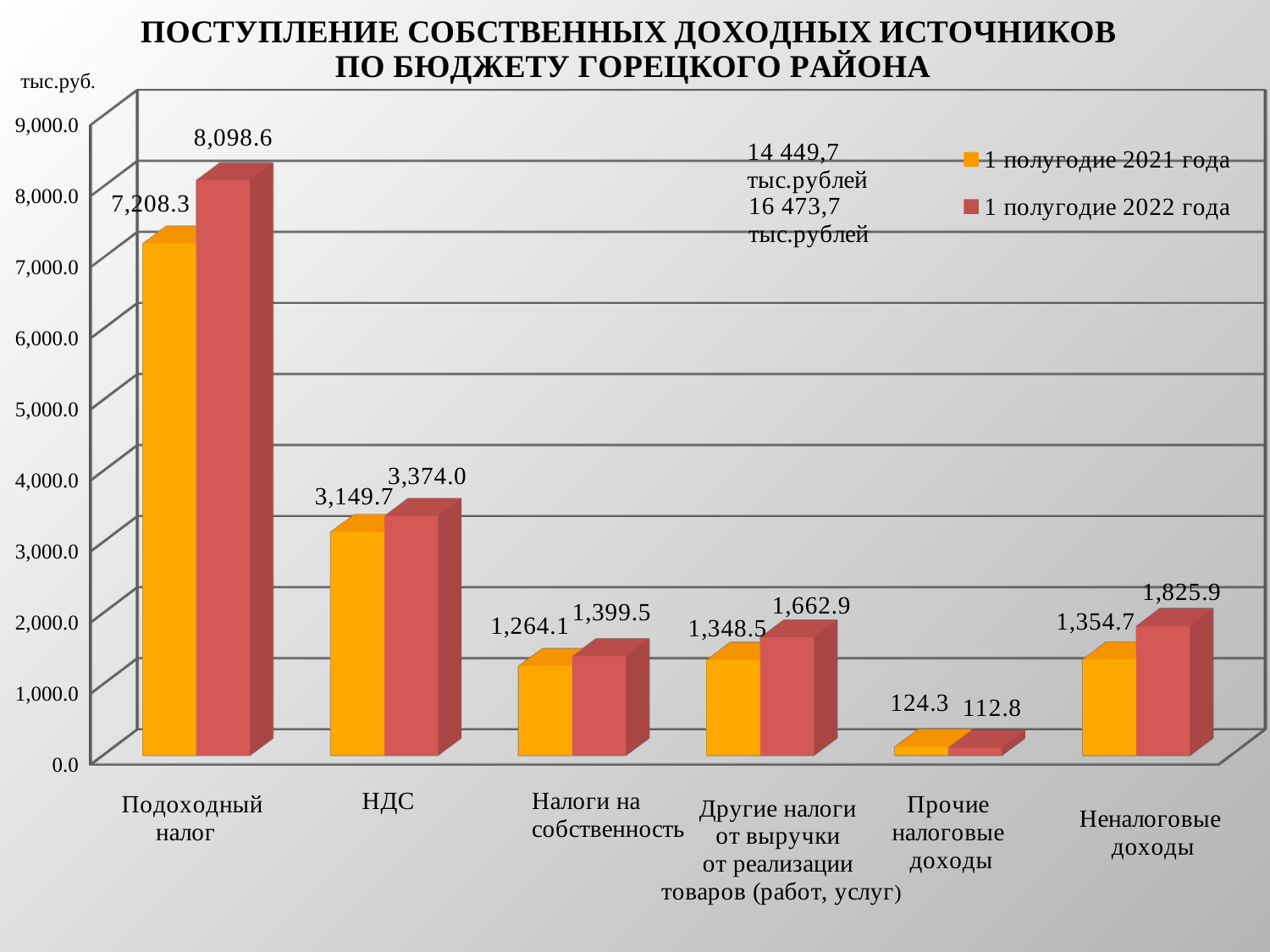
What kind of chart is shown on the slide? Bar chart How many categories are shown on the x axis? 6 What is the value for Подоходный налог in 1 полугодие 2022 года? 8,098.6 What is the value for Прочие налоговые доходы in 1 полугодие 2022 года? 112.8 How many series does the legend list? 2 Which category has the lowest value in 1 полугодие 2021 года? Прочие налоговые доходы Which is larger for Прочие налоговые доходы: the 1 полугодие 2021 года value or the 1 полугодие 2022 года value? 1 полугодие 2021 года Which category has the highest value in 1 полугодие 2022 года? Подоходный налог What is the value for Неналоговые доходы in 1 полугодие 2021 года? 1,354.7 What unit is shown at the top of the vertical axis? тыс.руб. What is the value for НДС in 1 полугодие 2021 года? 3,149.7 What is the difference between the 1 полугодие 2022 года and 1 полугодие 2021 года values for Подоходный налог? 890.3